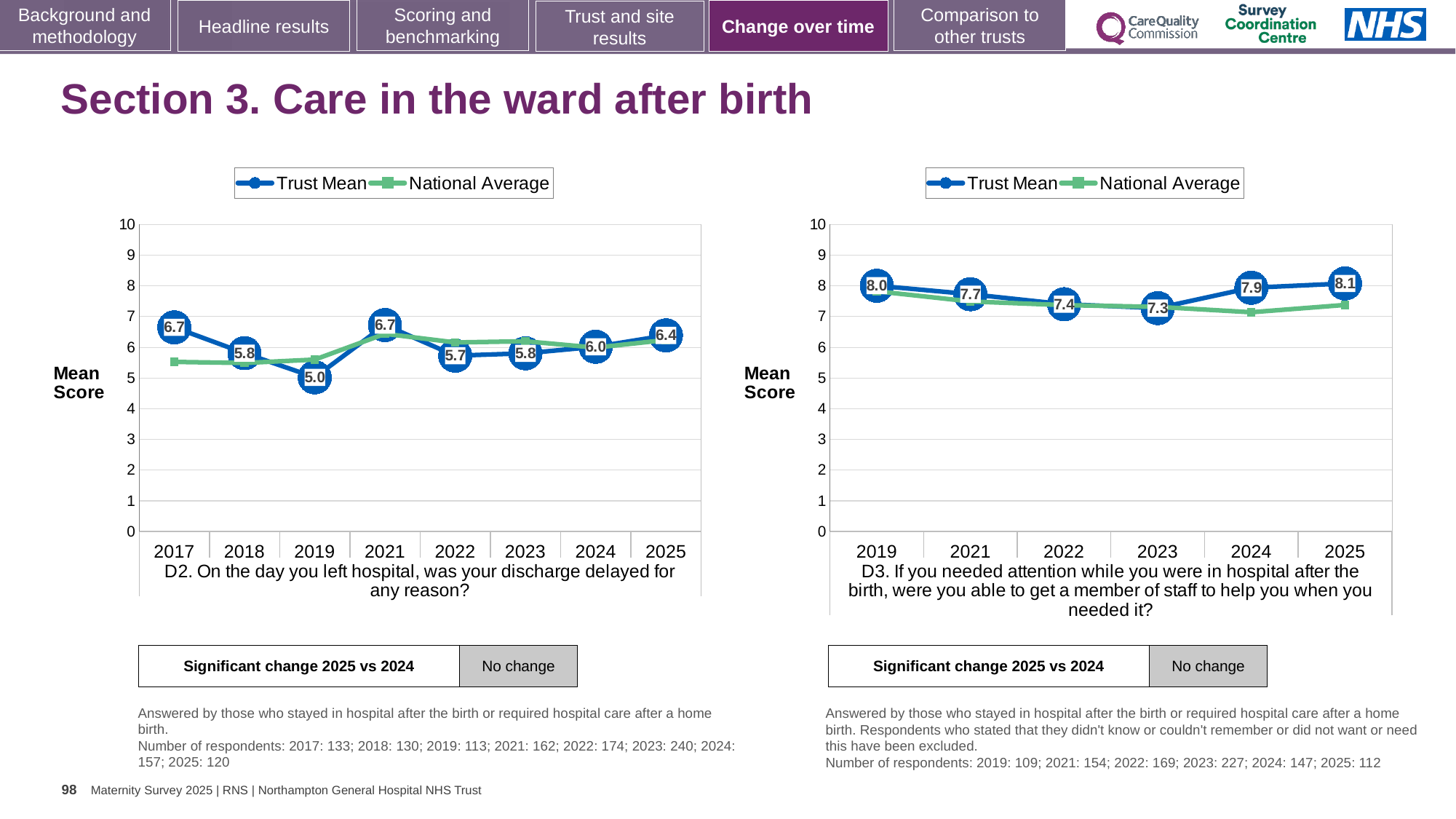
In the D3 chart (right), which year has the lowest Trust Mean score? 2023 In the D2 chart (left), what is the difference between the Trust Mean scores for 2021 and 2019? 1.7 In the D3 chart (right), is the National Average value for 2024 greater or less than 8? less In the D2 chart (left), how many years are plotted on the x axis? 8 In the D2 chart (left), which year has the lowest Trust Mean score? 2019 How many series does the legend of the D3 chart (right) list? 2 In the D3 chart (right), what is the Trust Mean score for 2023? 7.3 In the D2 chart (left), what is the Trust Mean score for 2025? 6.4 In the D3 chart (right), which year has the highest Trust Mean score? 2025 In the D3 chart (right), is the Trust Mean score for 2024 or 2022 larger? 2024 In the D3 chart (right), what is the difference between the Trust Mean scores for 2025 and 2024? 0.2 In the D2 chart (left), what is the Trust Mean score for 2019? 5.0